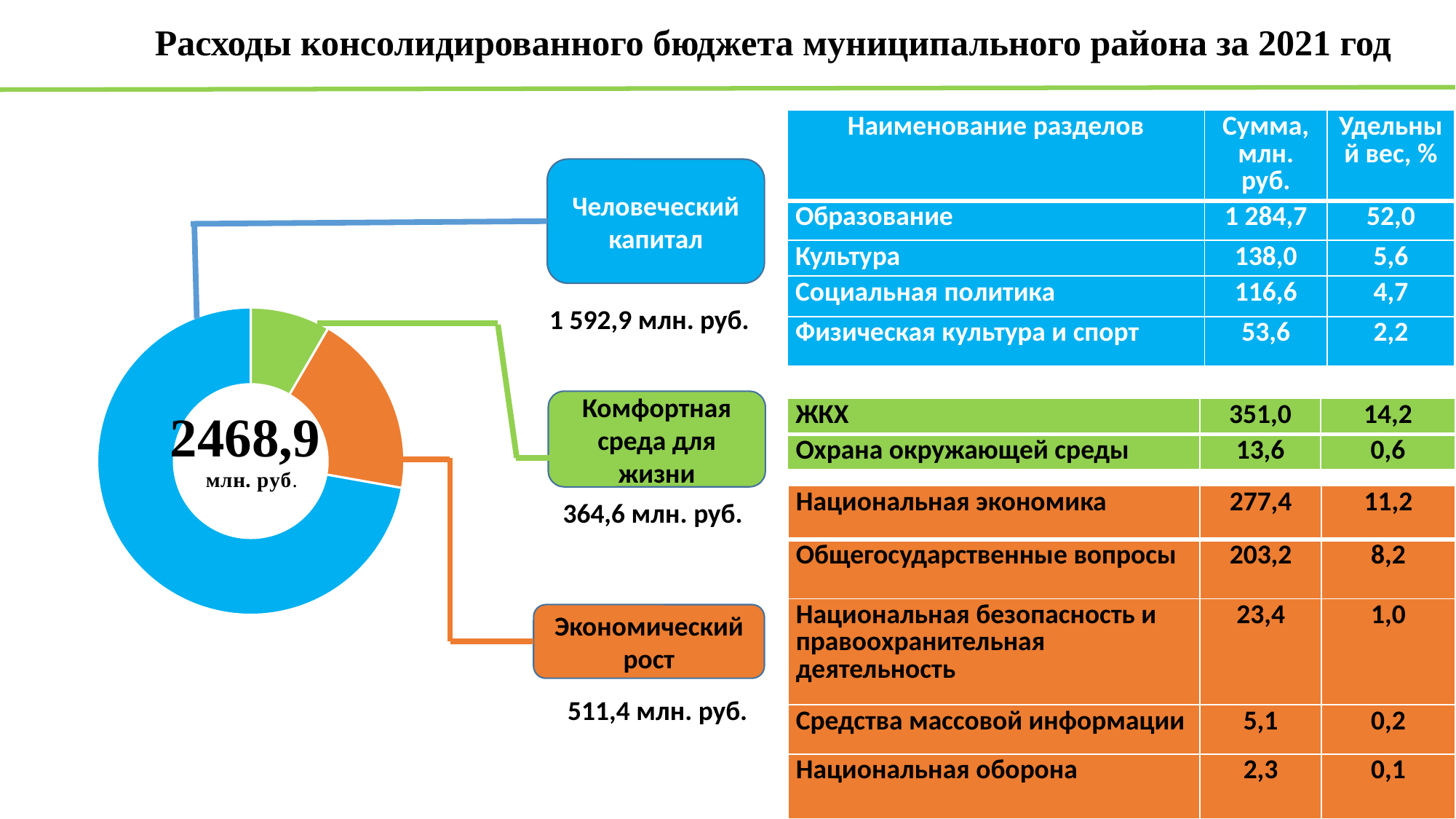
Which segment of the donut chart has the largest value? Человеческий капитал How many segments does the donut chart have? 3 Which segment of the donut chart has the smallest value? Комфортная среда для жизни What kind of chart is shown on the left of the slide? donut chart What value is shown for Комфортная среда для жизни on the donut chart? 364,6 млн. руб. What value is shown for Человеческий капитал on the donut chart? 1 592,9 млн. руб. Which is larger on the donut chart: Экономический рост or Комфортная среда для жизни? Экономический рост What colour is the Экономический рост segment of the donut chart? orange What value is shown for Экономический рост on the donut chart? 511,4 млн. руб. What total is printed in the centre of the donut chart? 2468,9 млн. руб. What is the difference between Экономический рост and Комфортная среда для жизни on the donut chart, in млн. руб.? 146,8 What is the difference between Человеческий капитал and Экономический рост on the donut chart, in млн. руб.? 1 081,5